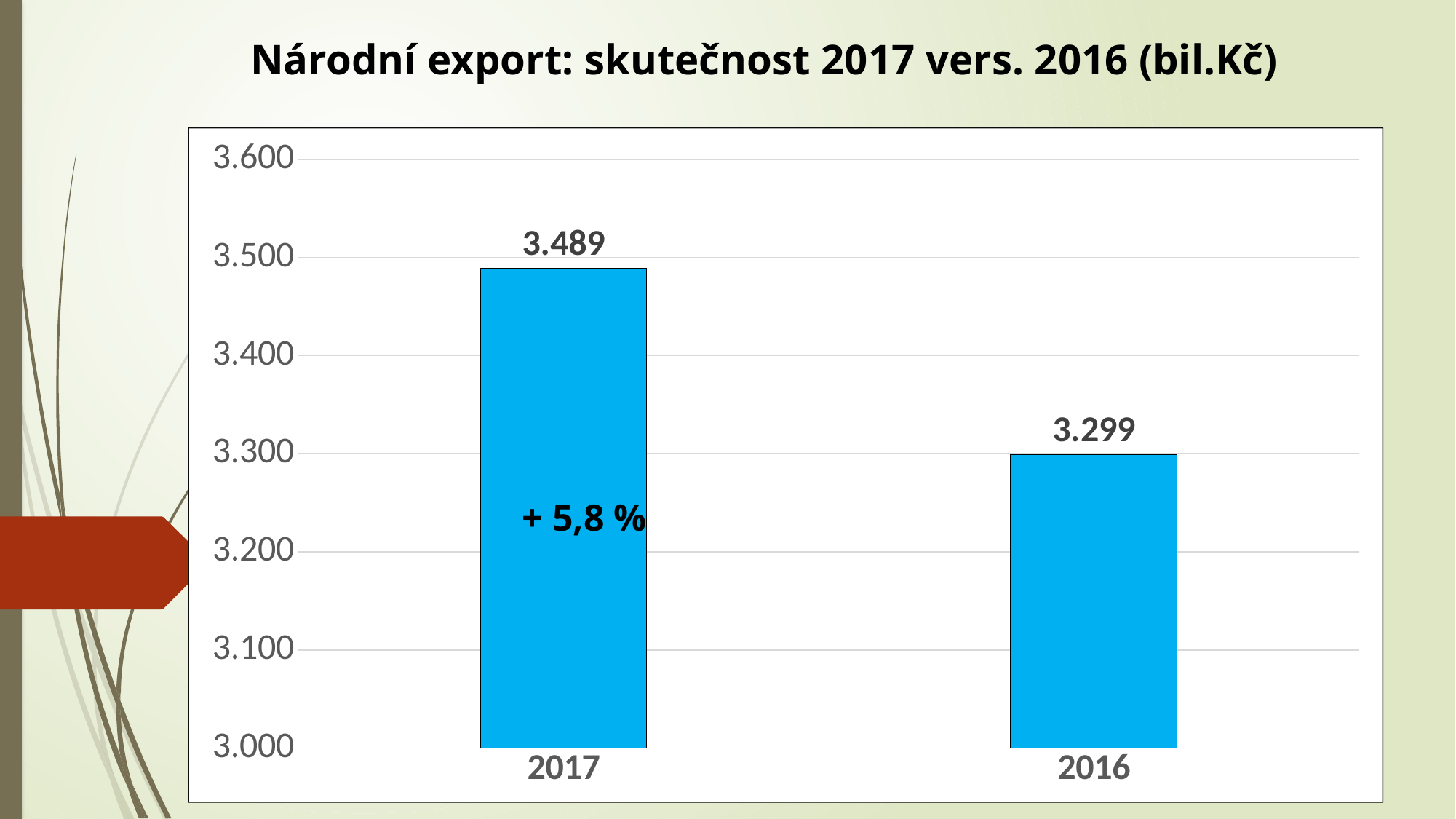
What is the title of the chart? Národní export: skutečnost 2017 vers. 2016 (bil.Kč) Which year has the lower value? 2016 Which year has the higher value? 2017 How many bars are shown in the chart? 2 What percentage change is annotated on the 2017 bar? + 5,8 % What is the difference between the 2017 value and the 2016 value? 190 Is the value for 2016 greater or less than 3.400? less What kind of chart is shown on the slide? bar chart Is the value for 2017 larger or smaller than the value for 2016? larger What is the value for 2016? 3.299 Is the value for 2017 greater or less than 3.400? greater What is the value for 2017? 3.489